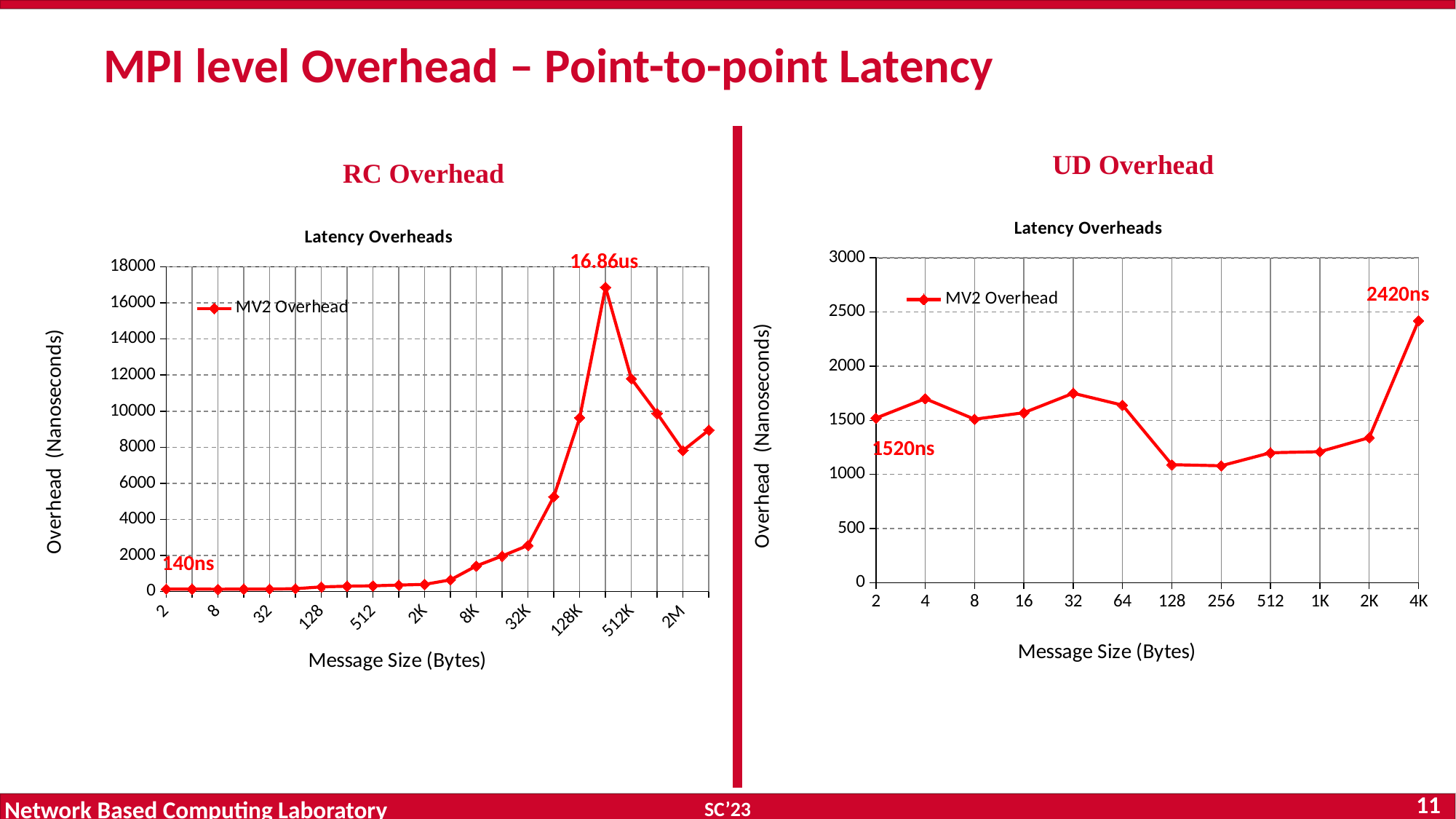
On the RC Overhead chart, what is the peak overhead value labelled on the chart? 16.86us On the RC Overhead chart, what is the overhead at message size 2? 140ns On the UD Overhead chart, is the overhead at message size 128 greater or less than 1500? less On the UD Overhead chart, how many series does the legend list? 1 On the UD Overhead chart, how many message-size points are plotted? 12 On the RC Overhead chart, what kind of chart is shown? line chart On the UD Overhead chart, which message size has the highest overhead? 4K On the UD Overhead chart, what is the overhead at message size 4K? 2420ns On the RC Overhead chart, what is the name of the series in the legend? MV2 Overhead On the UD Overhead chart, what is the difference between the overhead at 4K and at 2? 900ns On the RC Overhead chart, is the overhead at message size 2M greater or less than 10000? less On the UD Overhead chart, what is the overhead at message size 2? 1520ns